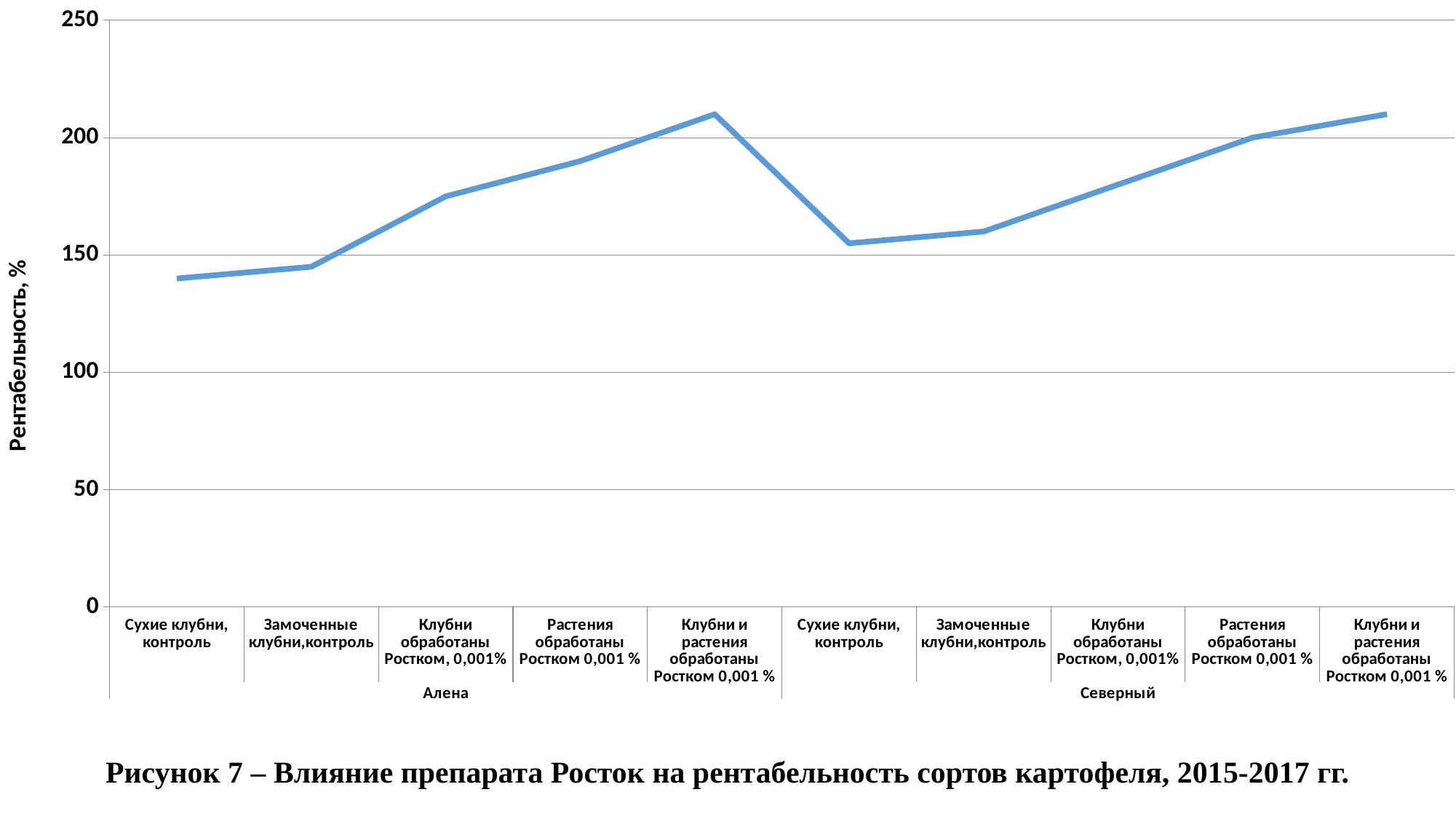
Is the value for 'Клубни обработаны Ростком, 0,001%' for Алена greater or less than 200? less What type of chart is shown on the slide? line chart Which is larger for Северный: 'Замоченные клубни,контроль' or 'Растения обработаны Ростком 0,001 %'? Растения обработаны Ростком 0,001 % How many data points are plotted on the line? 10 Is the value for 'Сухие клубни, контроль' for Северный greater or less than 150? greater Is the value for 'Сухие клубни, контроль' for Алена greater or less than 150? less Which two potato varieties are labelled along the x axis? Алена and Северный Within the Северный group, do the values rise or fall from left to right? rise What is the y-axis title of the chart? Рентабельность, % Within the Алена group, do the values rise or fall from 'Сухие клубни, контроль' to 'Клубни и растения обработаны Ростком 0,001 %'? rise Which is larger: the value for 'Сухие клубни, контроль' for Алена or for Северный? Северный